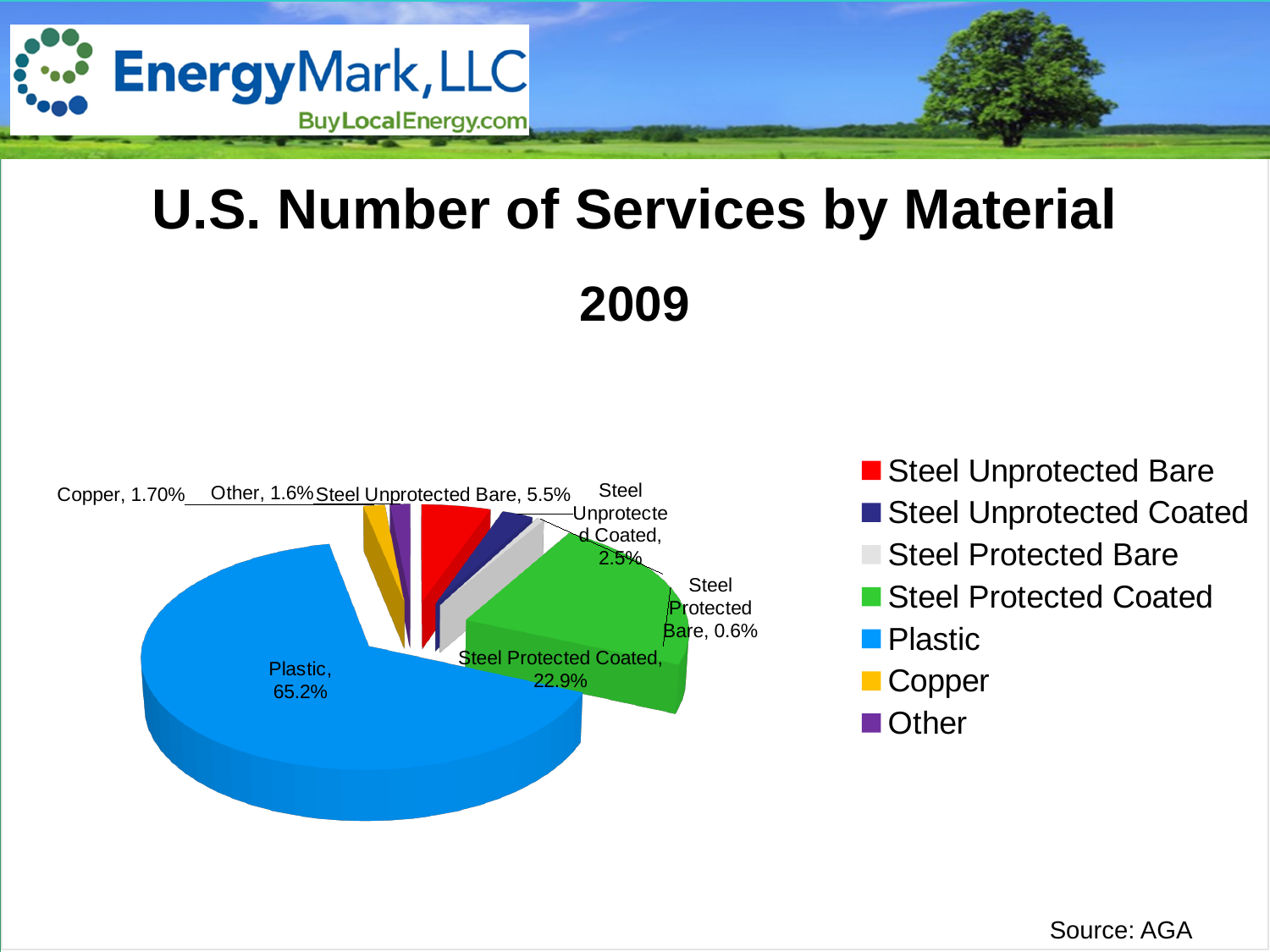
What share of U.S. services by material is Steel Protected Bare? 0.6% What share of U.S. services by material is Steel Unprotected Bare? 5.5% Which has a larger share, Steel Unprotected Bare or Steel Unprotected Coated? Steel Unprotected Bare What kind of chart is shown on the slide? Pie chart Which material has the largest share of U.S. services? Plastic What share of U.S. services by material is Steel Protected Coated? 22.9% How many material categories are shown in the pie chart? 7 What share of U.S. services by material is Plastic? 65.2% What is the difference in percentage points between the Plastic share and the Steel Protected Coated share? 42.3 Which material has the smallest share of U.S. services? Steel Protected Bare What share of U.S. services by material is Copper? 1.70% What colour is the Plastic slice in the pie chart? Blue